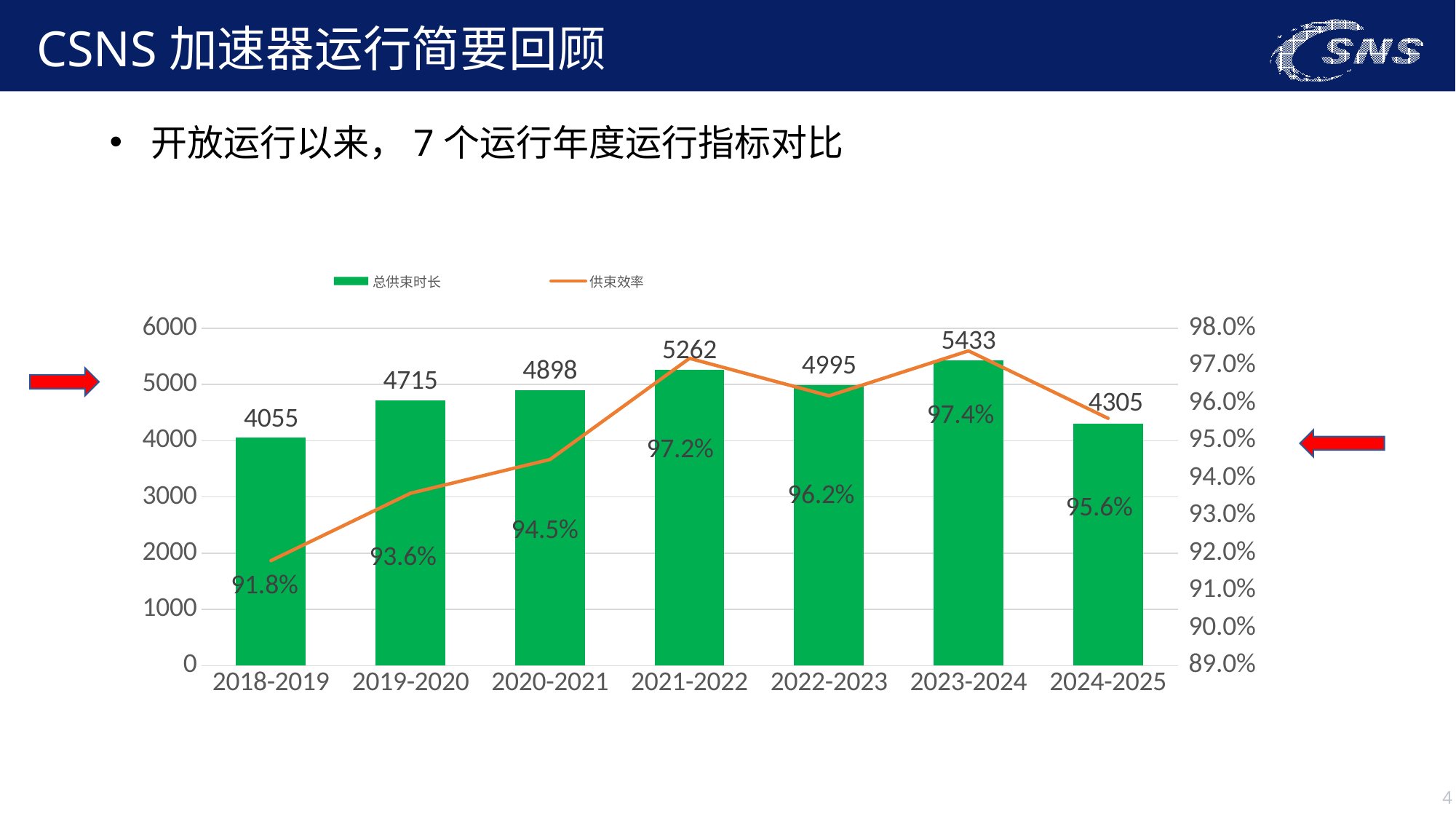
What colour are the 总供束时长 bars? green What is the 供束效率 value for 2018-2019? 91.8% Which year has the lowest 供束效率? 2018-2019 What kind of chart is used to show 总供束时长? bar chart What is the 总供束时长 value for 2024-2025? 4305 What is the 总供束时长 value for 2021-2022? 5262 What is the difference in 总供束时长 between 2023-2024 and 2018-2019? 1378 How many years are shown on the x axis? 7 Which is larger, the 总供束时长 for 2020-2021 or for 2022-2023? 2022-2023 How many series does the legend list? 2 Which year has the highest 总供束时长? 2023-2024 Is the 总供束时长 for 2019-2020 greater or less than 5000? less